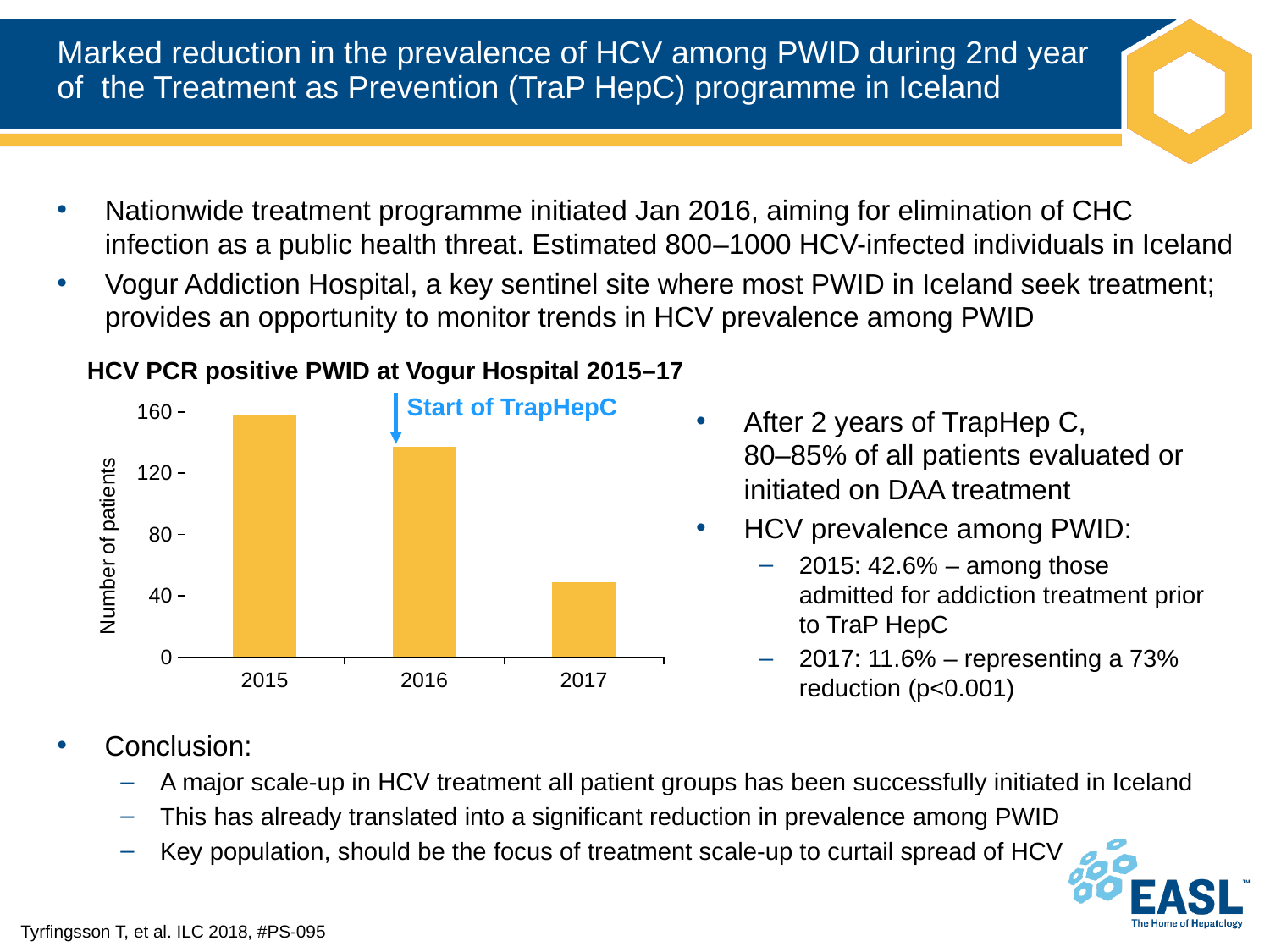
What kind of chart is shown on the slide? bar chart Which year has a larger number of patients, 2016 or 2017? 2016 What is the title of the chart? HCV PCR positive PWID at Vogur Hospital 2015–17 What is the label on the y axis of the chart? Number of patients Is the number of patients for 2015 greater or less than 120? greater Is the number of patients for 2017 greater or less than 80? less How many years (categories) are plotted on the x axis of the chart? 3 Which year has the lowest number of HCV PCR positive PWID? 2017 Do the values rise or fall from 2015 to 2017? fall Which year has a larger number of patients, 2015 or 2016? 2015 Is the number of patients for 2016 greater or less than 120? greater Which year has the highest number of HCV PCR positive PWID? 2015